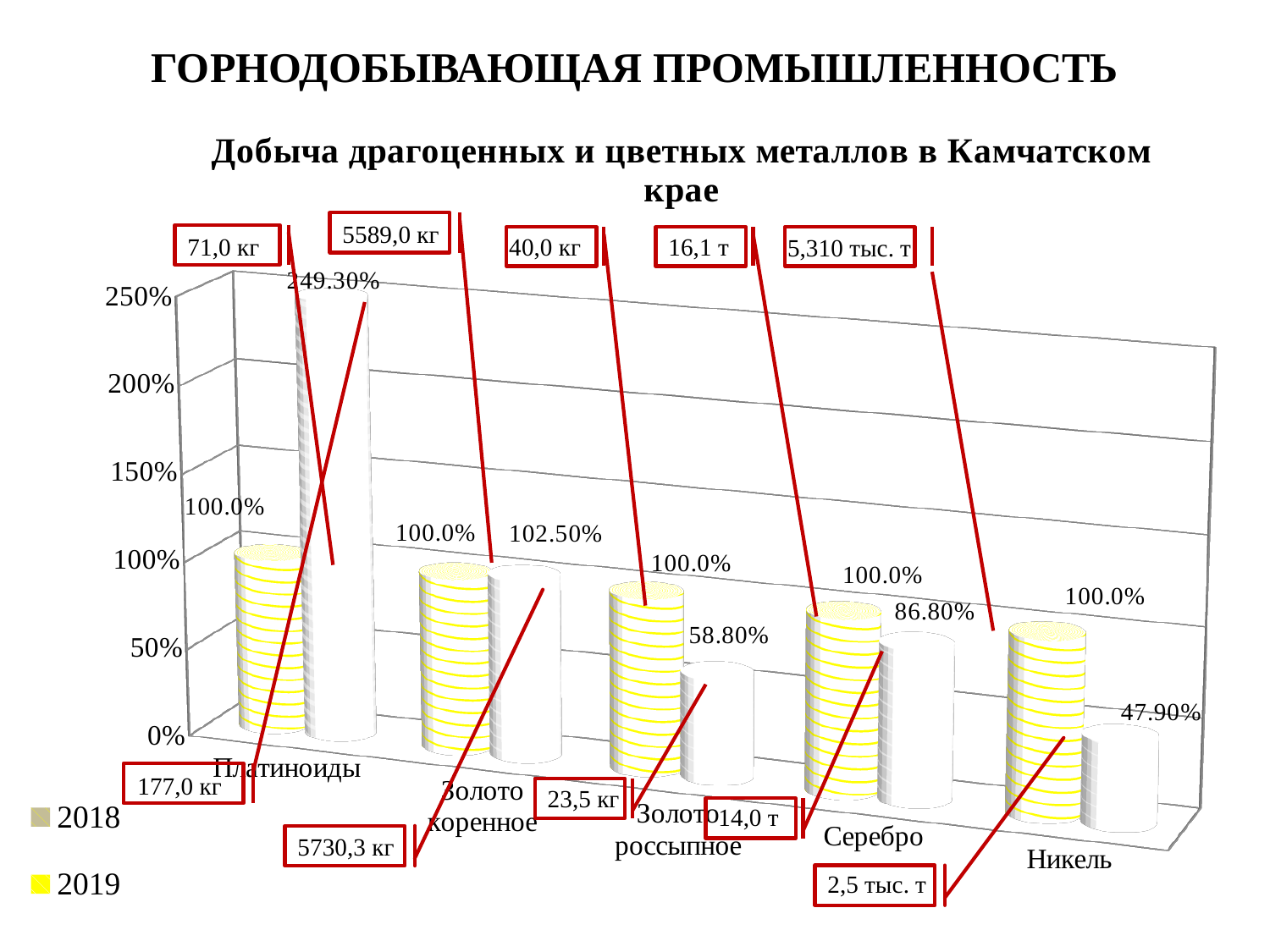
What is the difference between the 2019 values for Золото коренное and Золото россыпное? 43.70% Is the 2019 value for Платиноиды greater or less than 200%? greater Which category has the highest 2019 value? Платиноиды What is the 2018 value for Золото коренное? 100.0% Which category has the lowest 2019 value? Никель Which has the larger 2019 value, Серебро or Золото россыпное? Серебро What is the 2019 value for Платиноиды? 249.30% What is the 2019 value for Серебро? 86.80% What kind of chart is shown on the slide? bar chart How many series does the legend list? 2 What is the 2019 value for Никель? 47.90% How many categories are shown on the x axis? 5